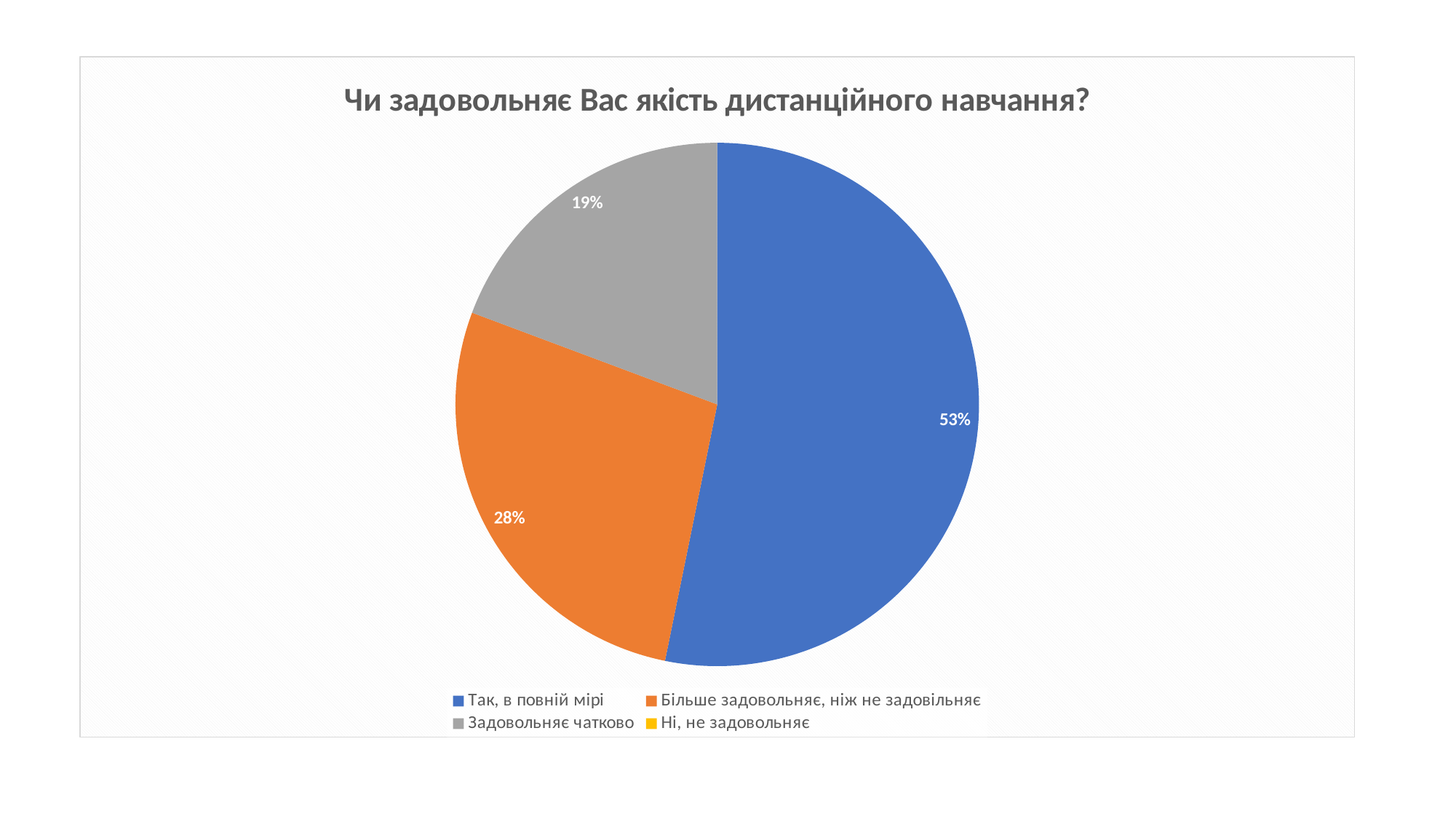
What share of the pie is labelled for "Так, в повній мірі"? 53% Which of the labelled slices is the smallest? Задовольняє чатково What is the title of the chart? Чи задовольняє Вас якість дистанційного навчання? What is the difference in percentage points between the "Так, в повній мірі" slice and the "Більше задовольняє, ніж не задовільняє" slice? 25 How many entries does the legend list? 4 What share of the pie is labelled for "Задовольняє чатково"? 19% What kind of chart is shown on the slide? pie chart Which category has the largest slice of the pie? Так, в повній мірі What share of the pie is labelled for "Більше задовольняє, ніж не задовільняє"? 28% Is the share for "Так, в повній мірі" greater or less than 50%? greater Which slice is larger: "Більше задовольняє, ніж не задовільняє" or "Задовольняє чатково"? Більше задовольняє, ніж не задовільняє What colour is the slice for "Задовольняє чатково"? grey